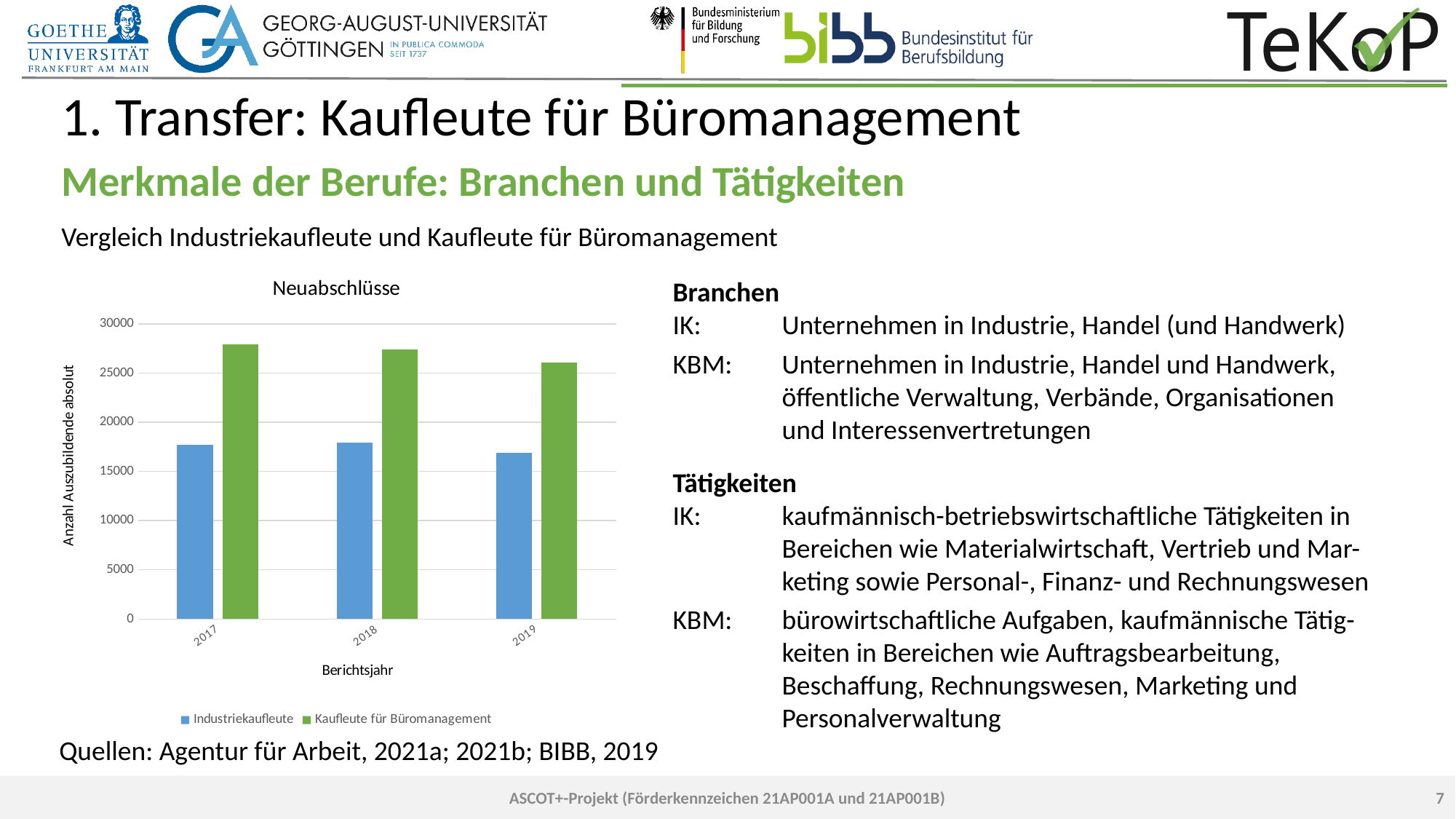
In which year is the value for Kaufleute für Büromanagement lowest? 2019 In 2018, which series has the larger value: Industriekaufleute or Kaufleute für Büromanagement? Kaufleute für Büromanagement How many years (Berichtsjahr) are shown on the x axis of the chart? 3 Do the values for Kaufleute für Büromanagement rise or fall from 2017 to 2019? fall What is the title of the chart? Neuabschlüsse What type of chart is shown on the slide? bar chart Which series is shown in green in the chart? Kaufleute für Büromanagement Is the value for Kaufleute für Büromanagement in 2017 greater or less than 25000? greater Is the value for Industriekaufleute in 2017 greater or less than 15000? greater Is the value for Industriekaufleute in 2019 greater or less than 20000? less How many series does the chart legend list? 2 In which year is the value for Industriekaufleute lowest? 2019